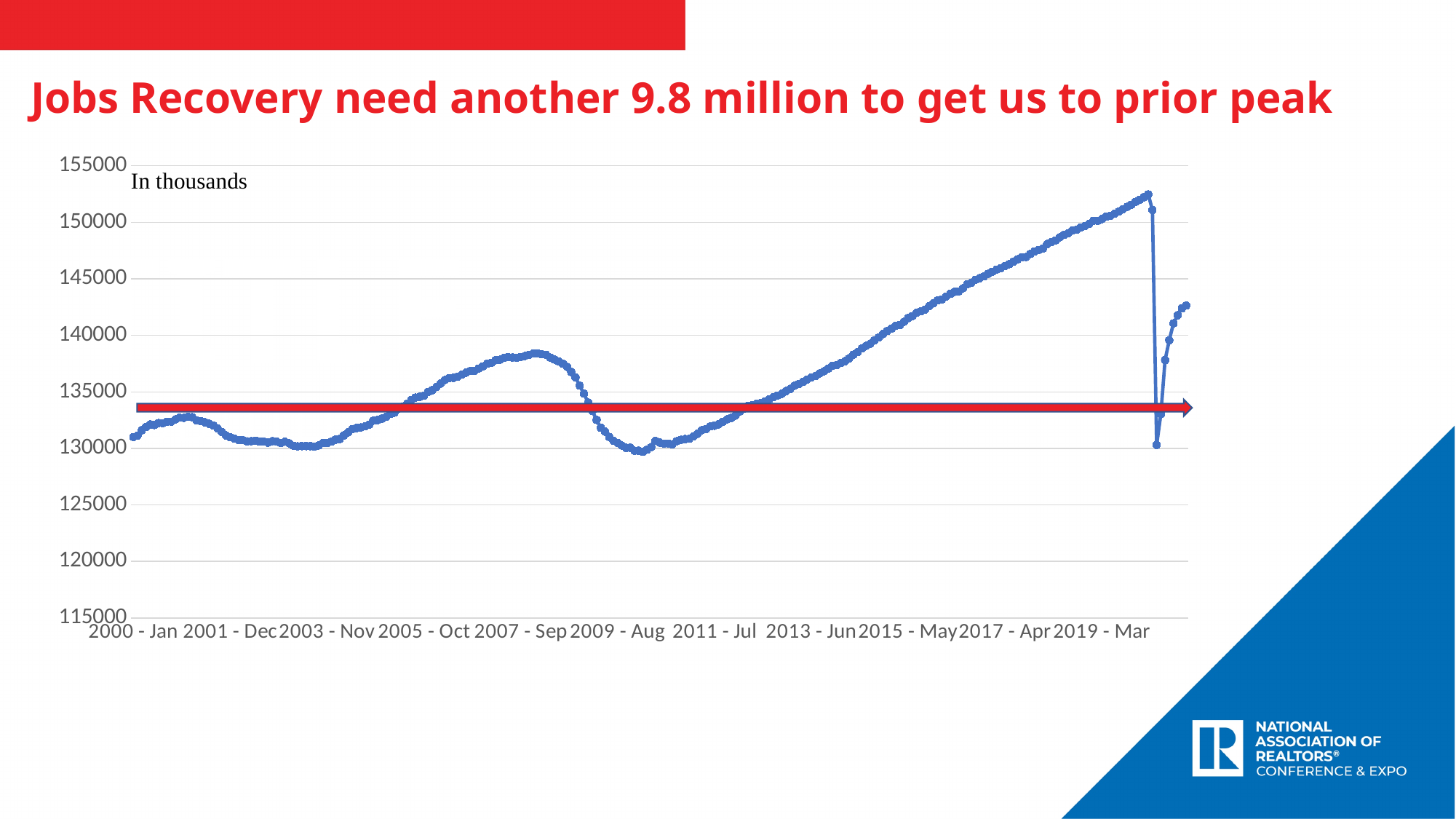
Is the value at 2013 - Jun greater or less than 140000? less How many date labels are shown along the x axis? 11 What kind of chart is shown on the slide? line chart Is the value at 2007 - Sep greater or less than 135000? greater Does the line rise or fall between 2007 - Sep and 2009 - Aug? fall In what units are the values on the chart expressed, according to the label near the top of the plot? In thousands Is the value at 2000 - Jan greater or less than 135000? less Does the line rise or fall between 2011 - Jul and 2019 - Mar? rise What is the title of the chart on the slide? Jobs Recovery need another 9.8 million to get us to prior peak